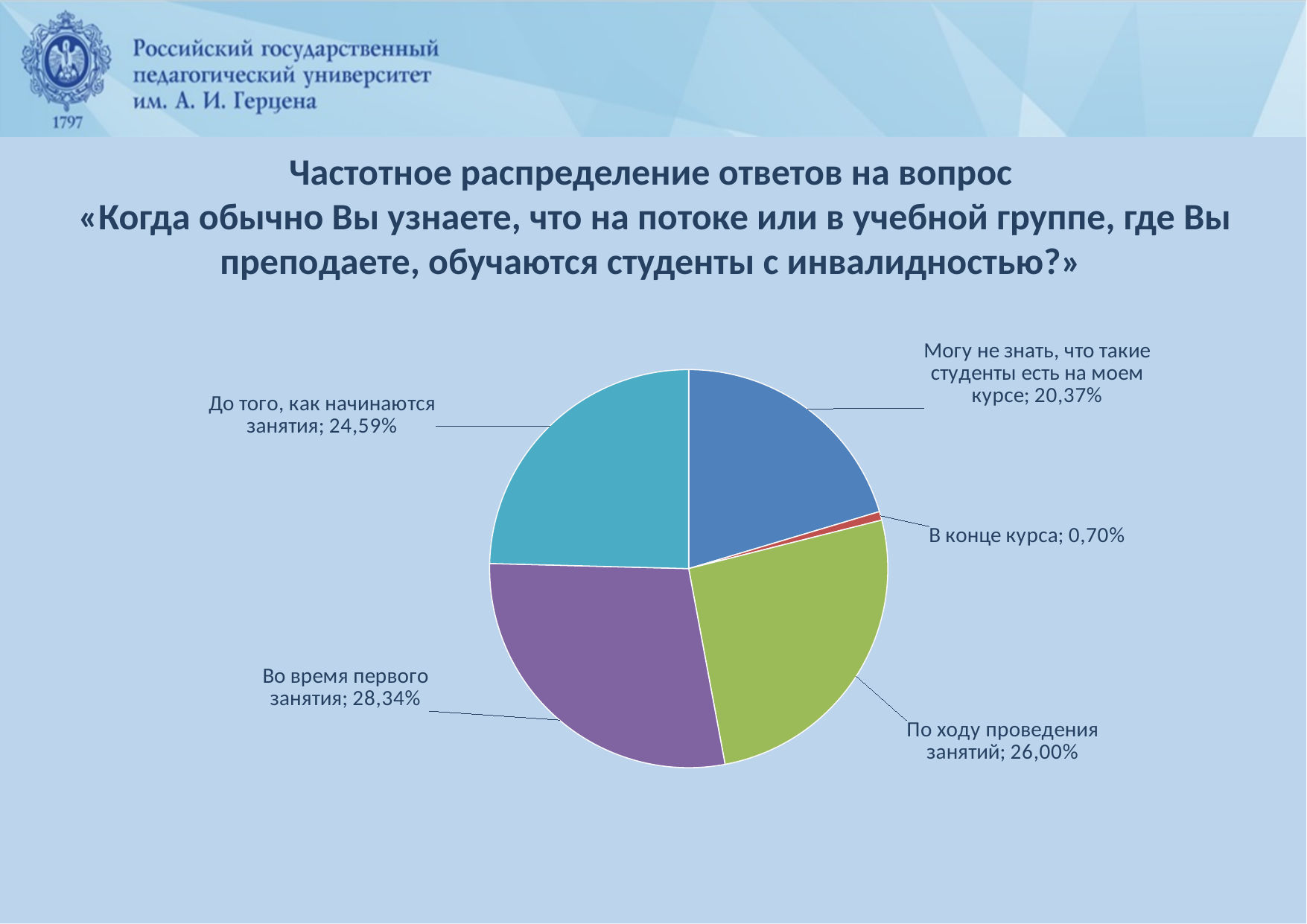
What colour is the slice for «По ходу проведения занятий»? Green What kind of chart is shown on the slide? Pie chart What is the difference between «До того, как начинаются занятия» and «Могу не знать, что такие студенты есть на моем курсе»? 4,22% What is the value for «По ходу проведения занятий»? 26,00% What is the value for «В конце курса»? 0,70% What is the value for «Во время первого занятия»? 28,34% What is the value for «Могу не знать, что такие студенты есть на моем курсе»? 20,37% Which category has the largest share of the pie? Во время первого занятия What is the difference between «Во время первого занятия» and «По ходу проведения занятий»? 2,34% Which is larger: «До того, как начинаются занятия» or «Могу не знать, что такие студенты есть на моем курсе»? До того, как начинаются занятия Which category has the smallest share of the pie? В конце курса How many slices does the pie chart have? 5